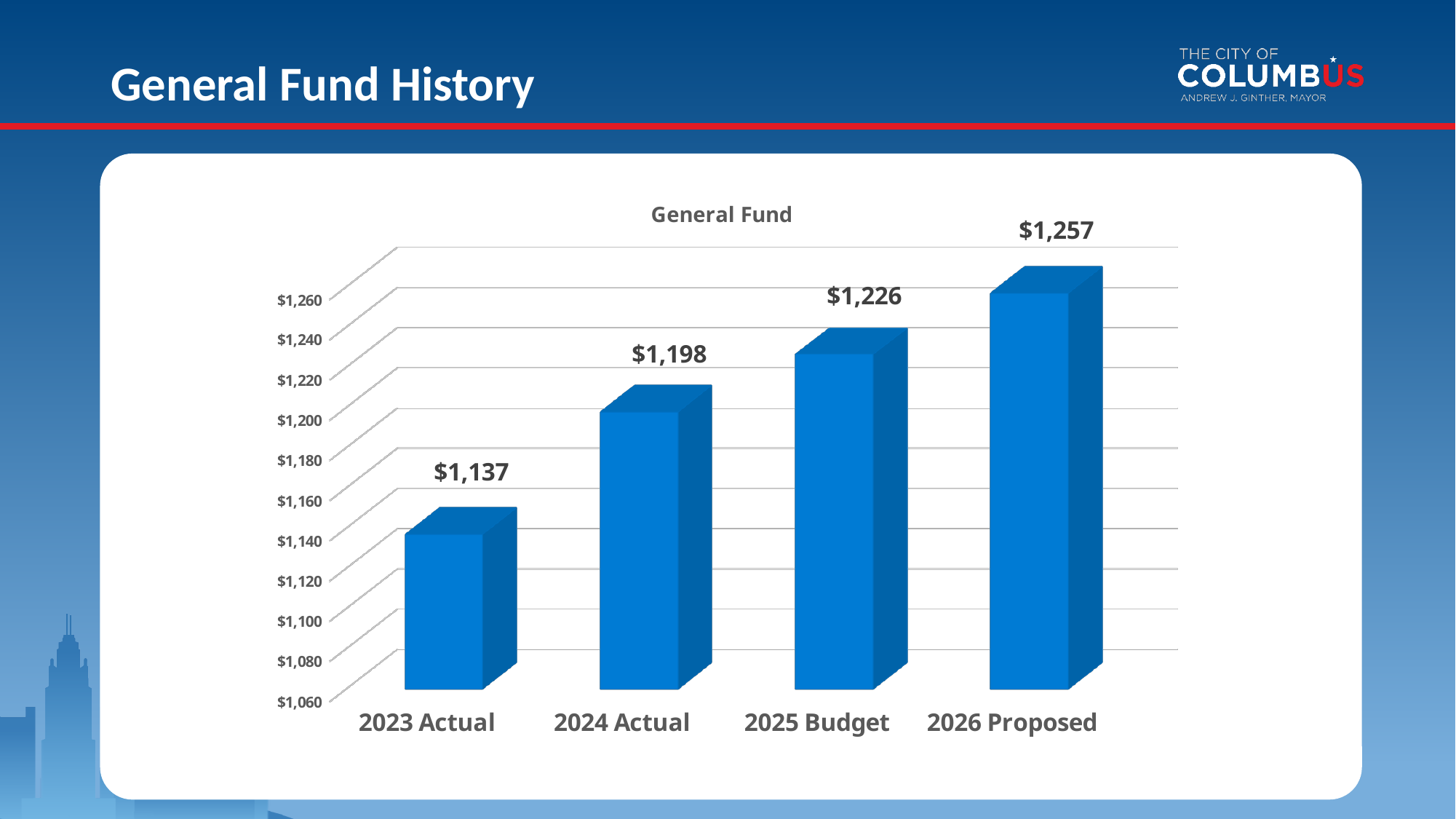
Which category has the highest value? 2026 Proposed Which category has the lowest value? 2023 Actual Do the values rise or fall from 2023 Actual to 2026 Proposed? Rise What is the value for 2026 Proposed? $1,257 What is the value for 2025 Budget? $1,226 What is the value for 2023 Actual? $1,137 What kind of chart is shown on the slide? Bar chart How many categories are shown on the x axis? 4 What is the difference between the 2026 Proposed and 2023 Actual values? $120 What is the value for 2024 Actual? $1,198 What is the difference between the 2025 Budget and 2024 Actual values? $28 Which is larger, the value for 2024 Actual or the value for 2025 Budget? 2025 Budget